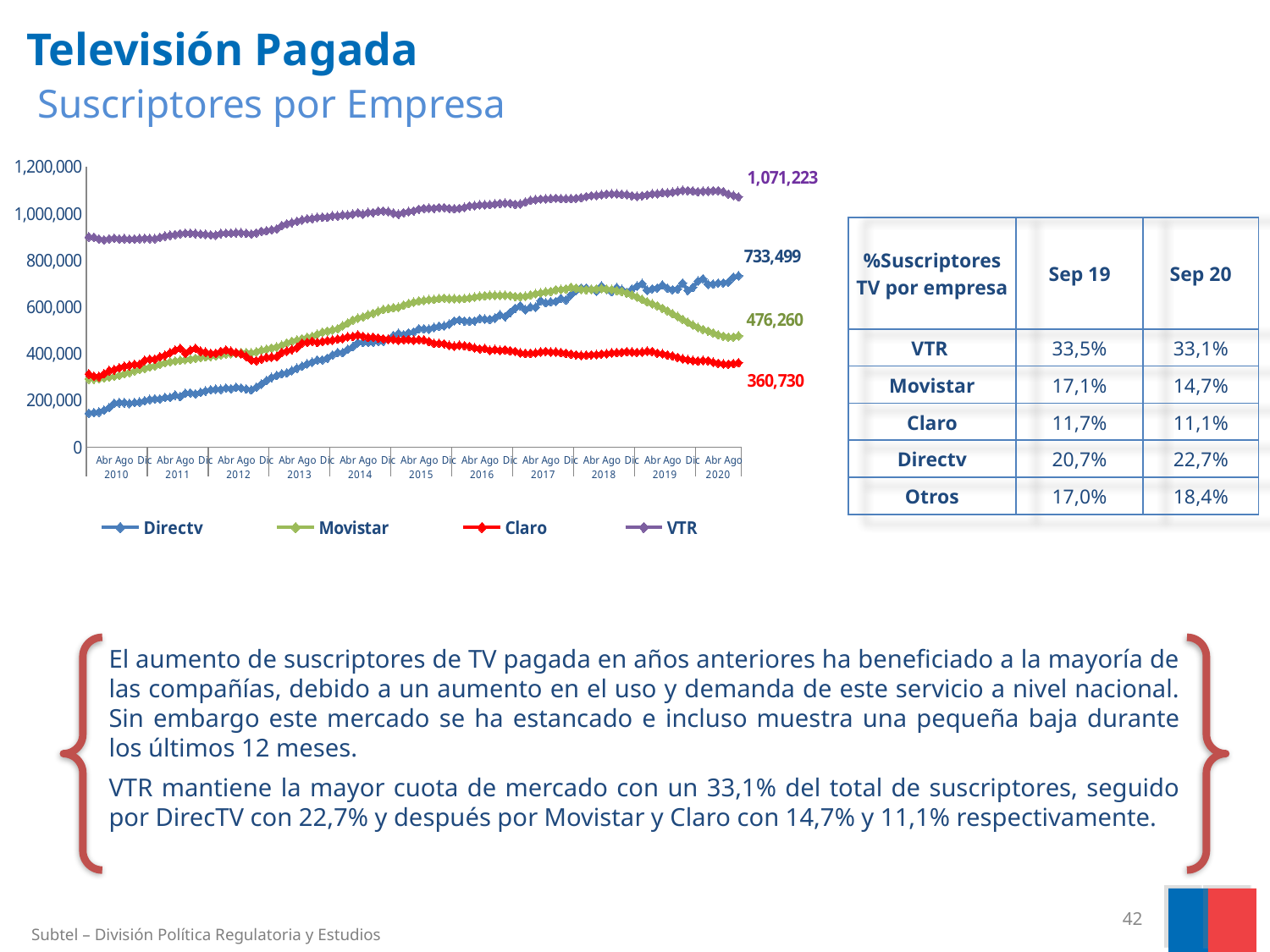
What is the final labelled value for the Claro series? 360,730 What is the difference between the final labelled values of VTR and Directv? 337,724 Which series has the lowest value at the end of the chart? Claro Which series has the highest value at the end of the chart? VTR What is the final labelled value for the Movistar series? 476,260 Is the value for Directv at the start of the chart in 2010 greater or less than 200,000? less How many series does the chart legend list? 4 Which series has a larger final labelled value, Movistar or Claro? Movistar Does the Directv series rise or fall overall from 2010 to 2020? rise What is the final labelled value for the VTR series? 1,071,223 What is the final labelled value for the Directv series? 733,499 What type of chart is shown on the slide? line chart